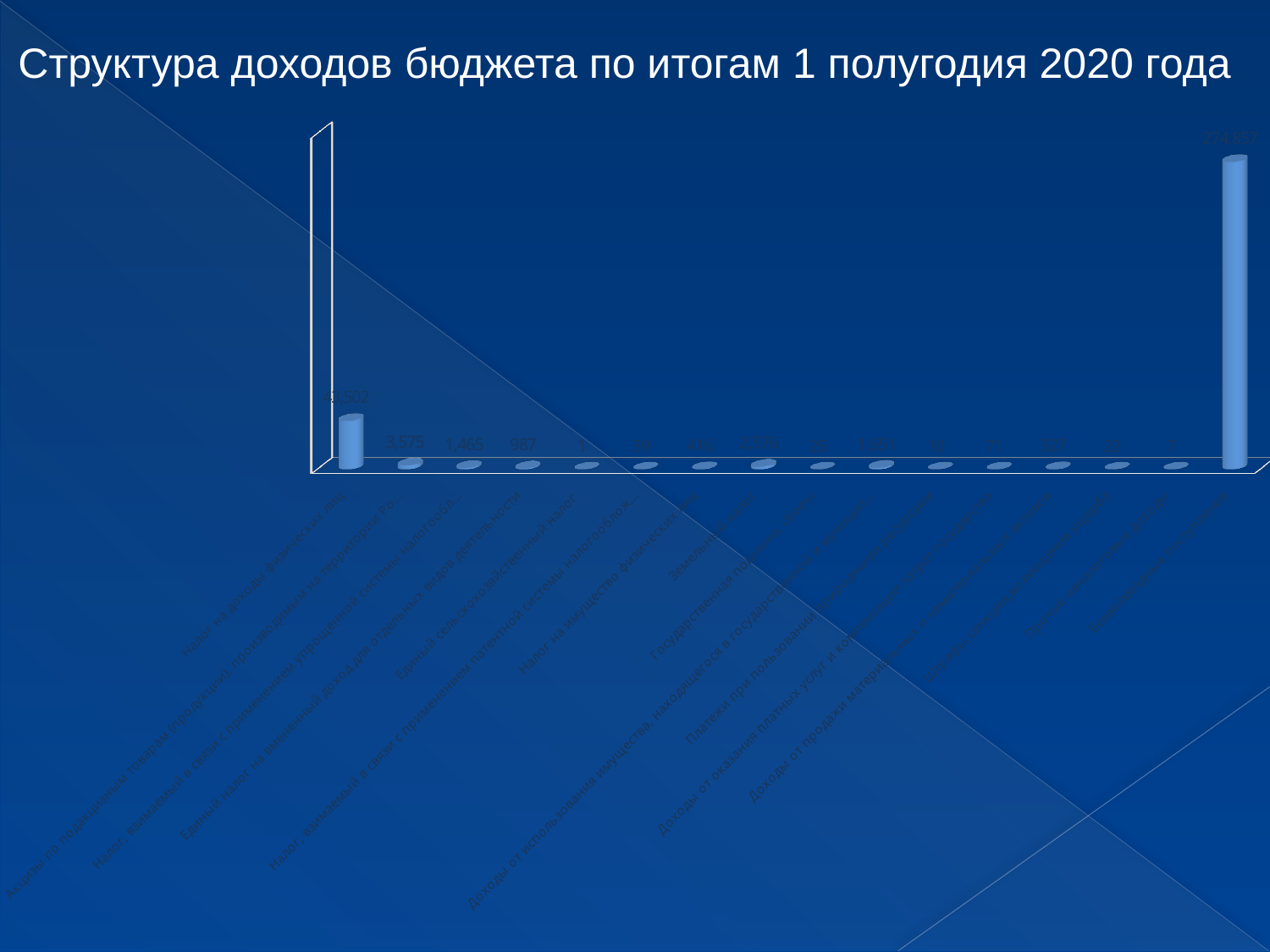
What is the value labelled for Акцизы по подакцизным товарам? 3,575 What is the title of the chart on the slide? Структура доходов бюджета по итогам 1 полугодия 2020 года How many categories are plotted on the chart? 16 What is the value labelled for Налог, взимаемый в связи с применением упрощенной системы налогообложения? 1,465 What kind of chart is shown on the slide? bar chart Which is larger: the value for Акцизы по подакцизным товарам or the value for Единый налог на вмененный доход? Акцизы по подакцизным товарам What is the largest value labelled on the chart? 274,857 What is the difference between the values for Акцизы по подакцизным товарам (3,575) and Налог по упрощенной системе налогообложения (1,465)? 2,110 Which bar is taller: the first bar (Налог на доходы физических лиц) or the last bar on the right? the last bar on the right What is the value labelled for Единый налог на вмененный доход для отдельных видов деятельности? 987 Does the chart have a legend? No